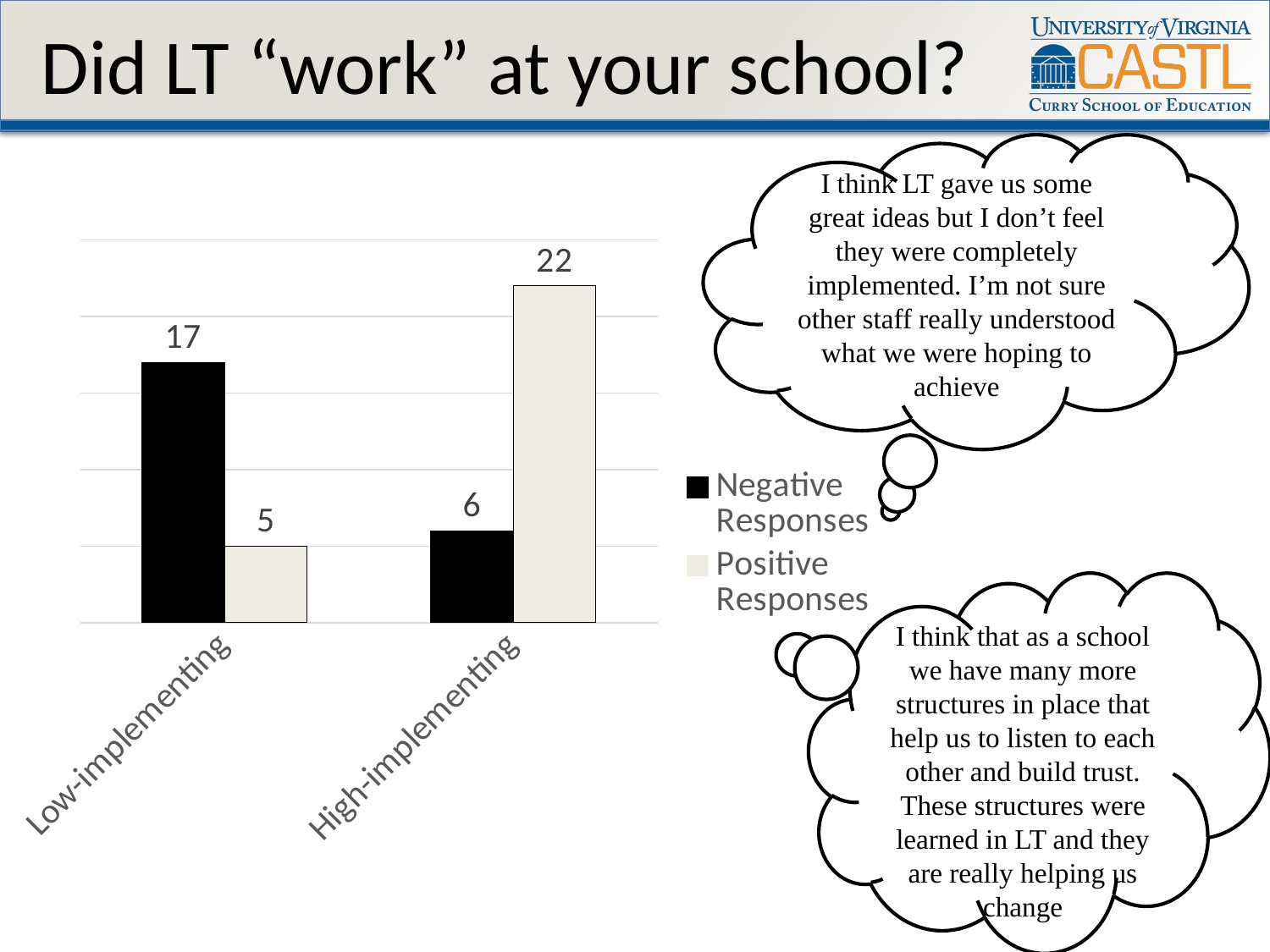
Which is larger for Low-implementing schools: Negative Responses or Positive Responses? Negative Responses What kind of chart is shown on the slide? bar chart How many series does the chart legend list? 2 Which category has the lowest Negative Responses value? High-implementing How many Positive Responses are shown for High-implementing schools? 22 How many Negative Responses are shown for High-implementing schools? 6 What is the difference between Positive Responses for High-implementing and Low-implementing schools? 17 How many Positive Responses are shown for Low-implementing schools? 5 How many categories are shown on the x axis of the chart? 2 Which category has the highest Positive Responses value? High-implementing How many Negative Responses are shown for Low-implementing schools? 17 What is the difference between Negative Responses for Low-implementing and High-implementing schools? 11